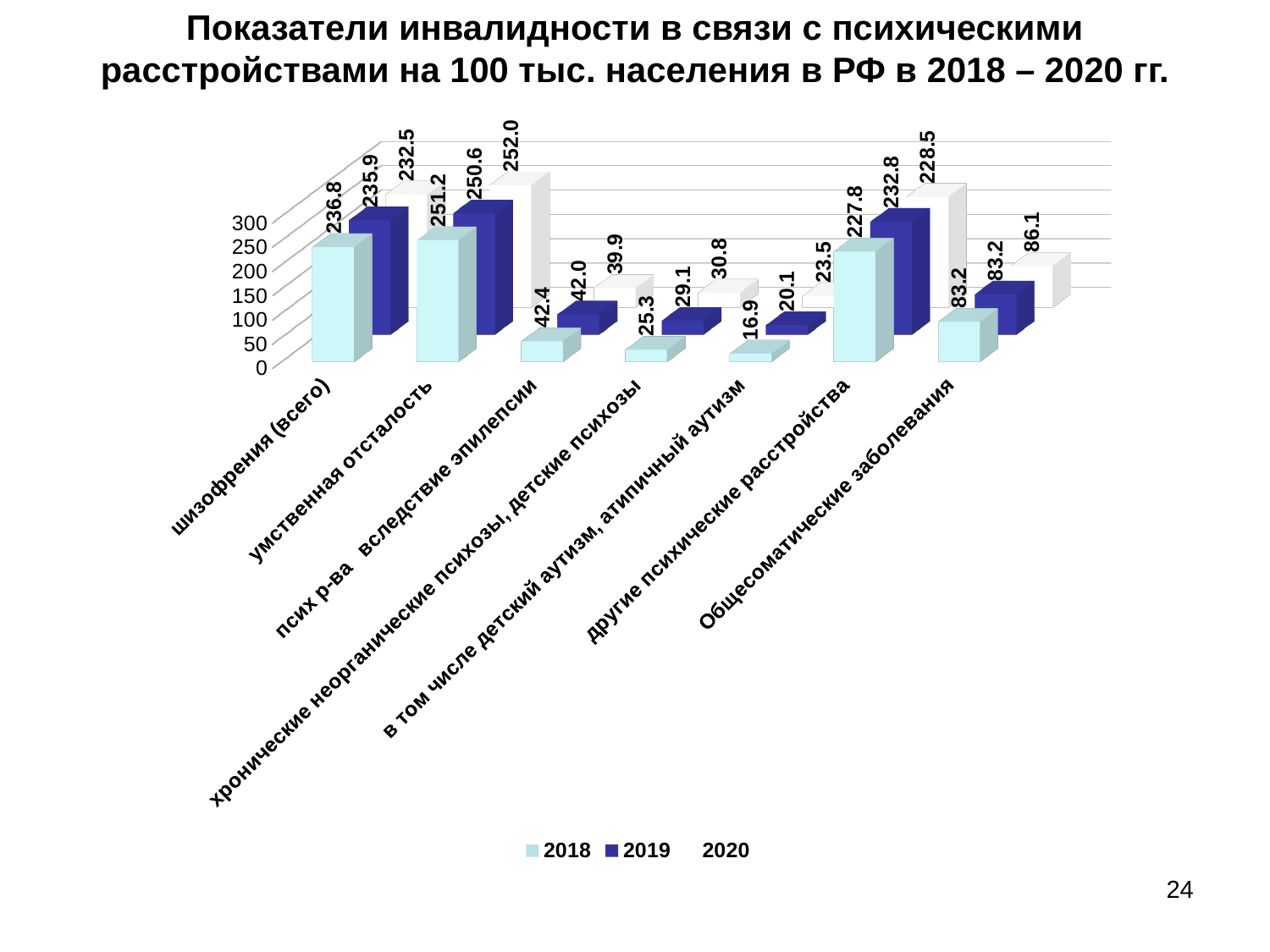
How many series does the legend list? 3 What is the 2020 value for Общесоматические заболевания? 86.1 Which is larger for другие психические расстройства: the 2019 value or the 2020 value? 2019 Which category has the highest value in 2020? умственная отсталость What is the 2018 value for шизофрения (всего)? 236.8 Is the 2019 value for псих р-ва вследствие эпилепсии greater or less than 50? less What is the 2020 value for умственная отсталость? 252.0 What kind of chart is shown on the slide? bar chart How many categories are shown on the x axis? 7 Which category has the lowest value in 2018? в том числе детский аутизм, атипичный аутизм What is the difference between the 2020 and 2018 values for в том числе детский аутизм, атипичный аутизм? 6.6 What is the 2019 value for хронические неорганические психозы, детские психозы? 29.1